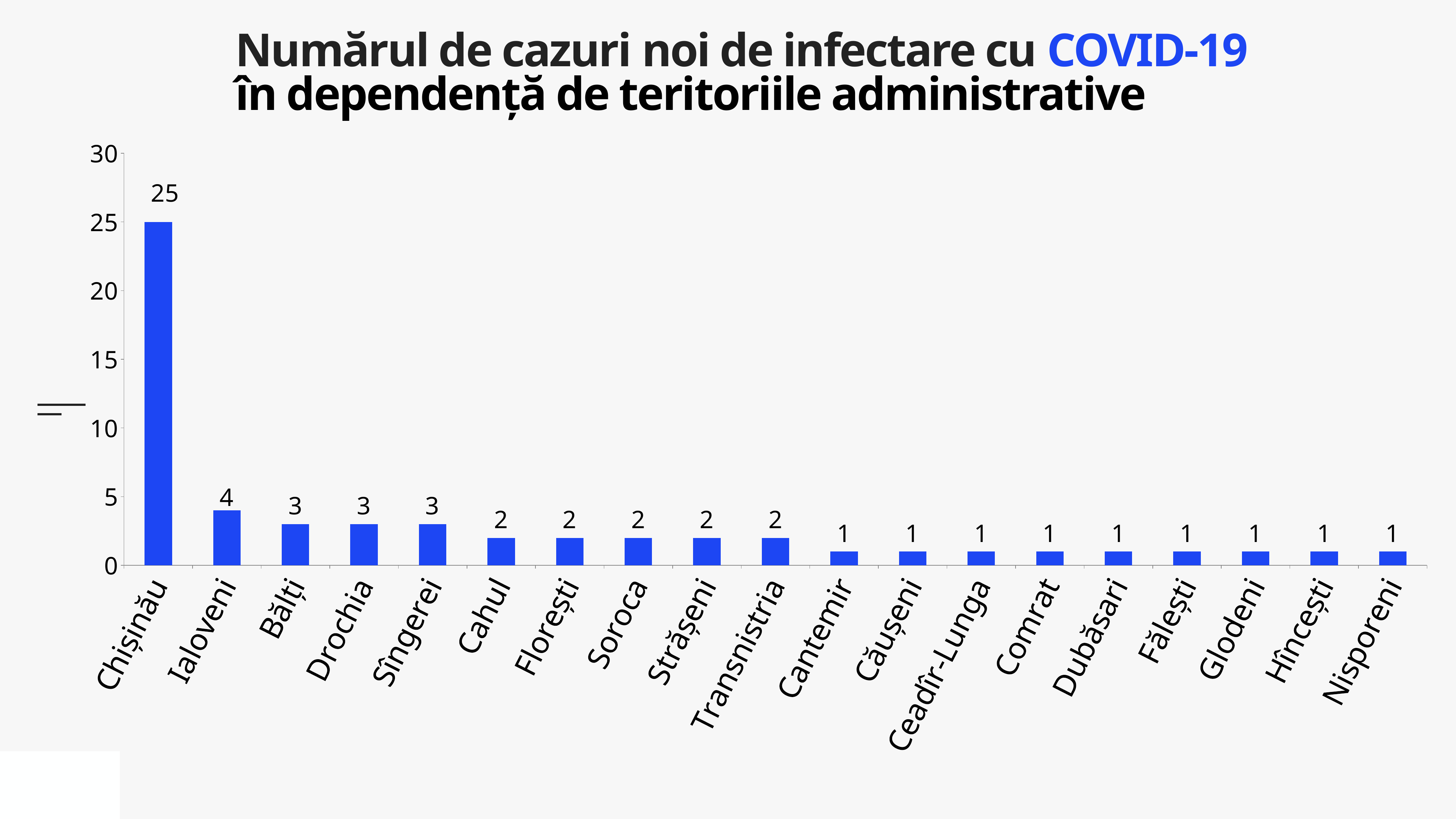
What is the value for Ialoveni? 4 What is the difference between the values for Chișinău and Ialoveni? 21 What is the difference between the values for Bălți and Cahul? 1 What is the value for Chișinău? 25 What kind of chart is shown on the slide? bar chart Is the value for Chișinău greater or less than 20? greater Which category has the highest value? Chișinău How many categories are shown on the x axis? 19 What is the value for Drochia? 3 What colour are the bars in the chart? blue Which is larger, the value for Ialoveni or the value for Soroca? Ialoveni What is the value for Transnistria? 2